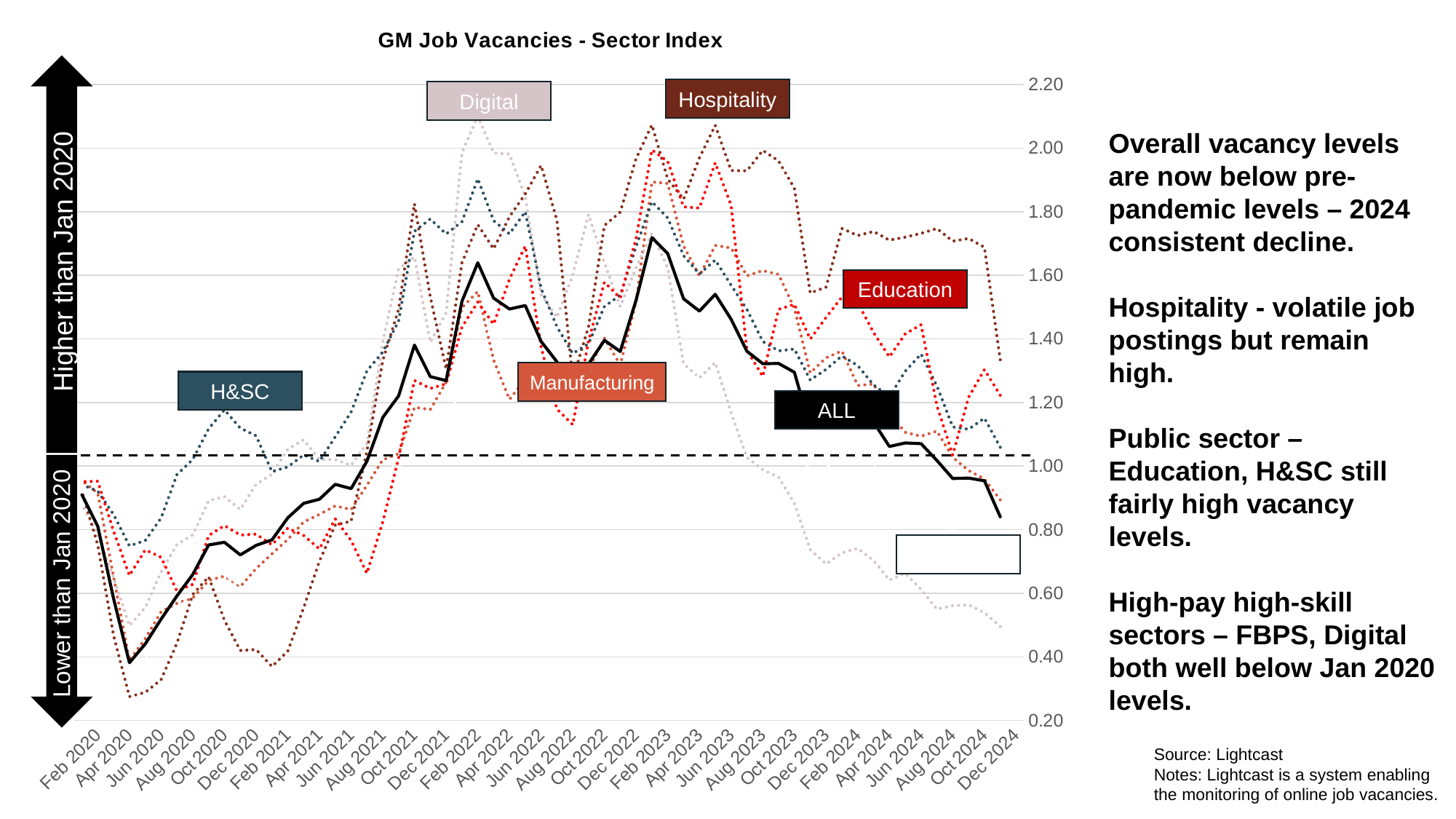
What kind of chart is shown on the slide? line chart What is the title of the chart? GM Job Vacancies - Sector Index Which labelled sector line is lowest at Dec 2024? Digital Does the ALL line rise or fall between Feb 2023 and Dec 2024? fall How many month labels are shown on the x axis? 30 Is the value of the ALL line at Dec 2024 greater or less than 1.00? less Is the value of the ALL line at Apr 2020 greater or less than 0.60? less Is the ALL line higher at Feb 2023 or at Dec 2024? Feb 2023 Is the Hospitality line at Feb 2024 greater or less than 1.60? greater What is the highest value shown on the y axis? 2.20